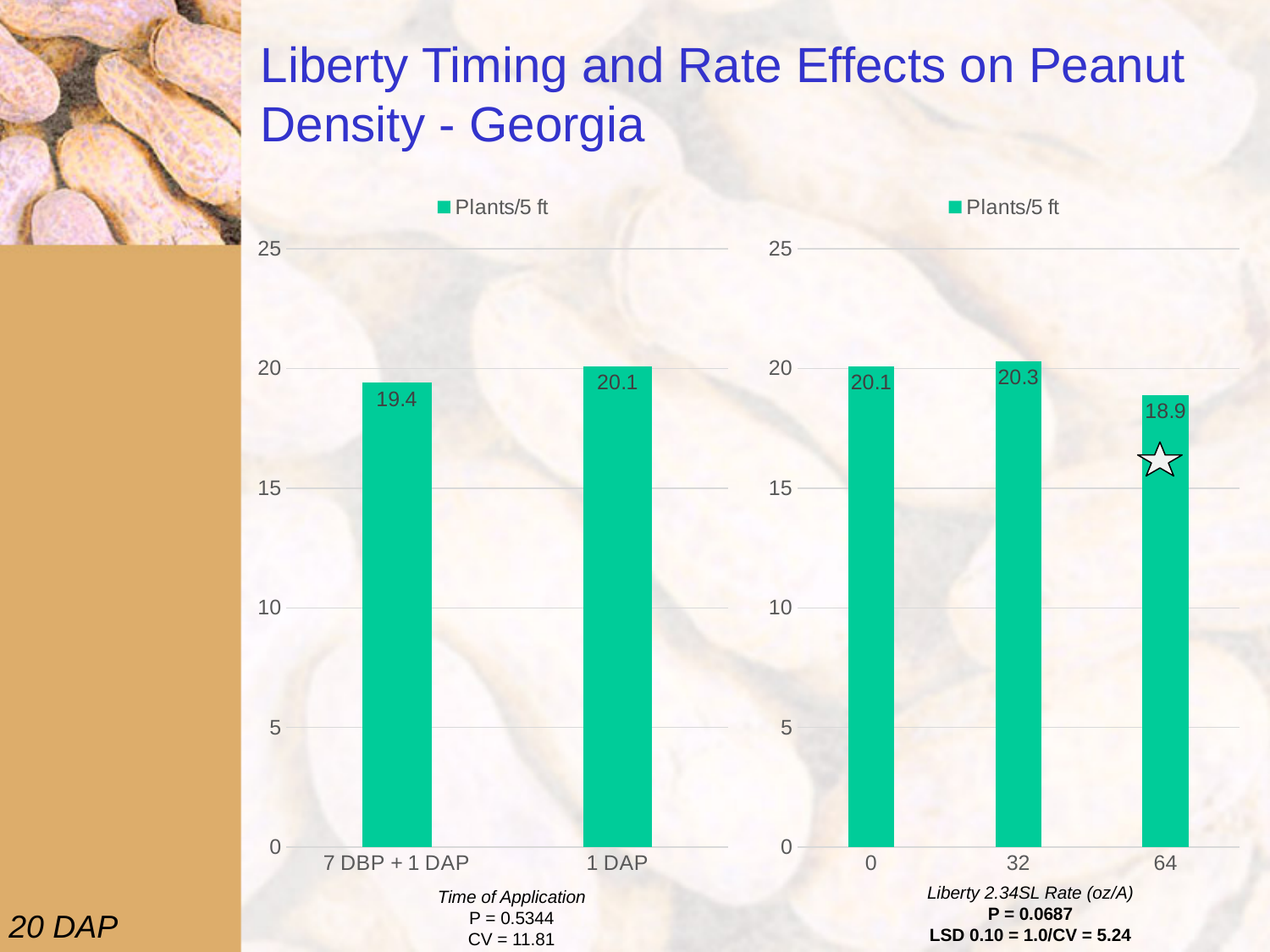
In the left chart (Time of Application), what is the difference between the 1 DAP and 7 DBP + 1 DAP values? 0.7 In the left chart (Time of Application), what is the Plants/5 ft value for 7 DBP + 1 DAP? 19.4 What kind of chart is used on the left side of the slide? Bar chart In the left chart (Time of Application), which category has the higher value? 1 DAP In the right chart (Liberty 2.34SL Rate), how many rate categories are shown? 3 In the right chart (Liberty 2.34SL Rate), what is the difference between the values at the 32 and 64 oz/A rates? 1.4 In the right chart (Liberty 2.34SL Rate), what is the Plants/5 ft value at the 32 oz/A rate? 20.3 In the right chart (Liberty 2.34SL Rate), is the value at the 0 rate greater or less than 20? greater In the left chart (Time of Application), what is the Plants/5 ft value for 1 DAP? 20.1 In the left chart (Time of Application), how many categories are shown on the x axis? 2 In the right chart (Liberty 2.34SL Rate), which rate has the lowest Plants/5 ft value? 64 In the right chart (Liberty 2.34SL Rate), what is the Plants/5 ft value at the 64 oz/A rate? 18.9